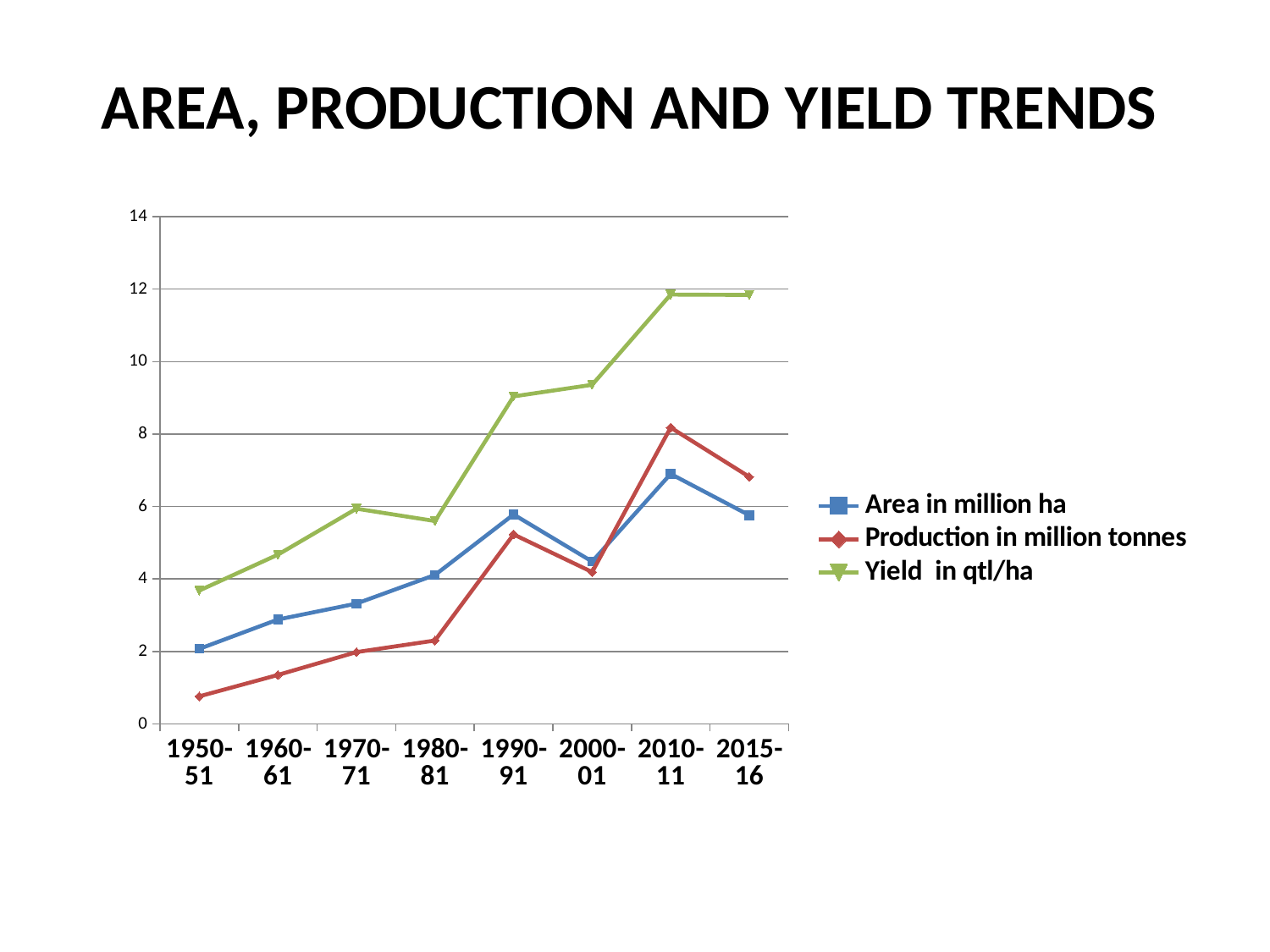
How many time periods are shown on the x axis? 8 What kind of chart is shown on the slide? Line chart What is the title of the slide? AREA, PRODUCTION AND YIELD TRENDS In which period is Production in million tonnes lowest? 1950-51 In which period is Area in million ha highest? 2010-11 Is the value for Production in million tonnes in 1950-51 greater or less than 2? less Does Production in million tonnes rise or fall from 2010-11 to 2015-16? Fall Is the value for Area in million ha in 1990-91 greater or less than 4? greater How many series does the legend list? 3 In which period is Production in million tonnes highest? 2010-11 Is the value for Yield in qtl/ha in 2010-11 greater or less than 10? greater In 2010-11, which is larger: Production in million tonnes or Area in million ha? Production in million tonnes